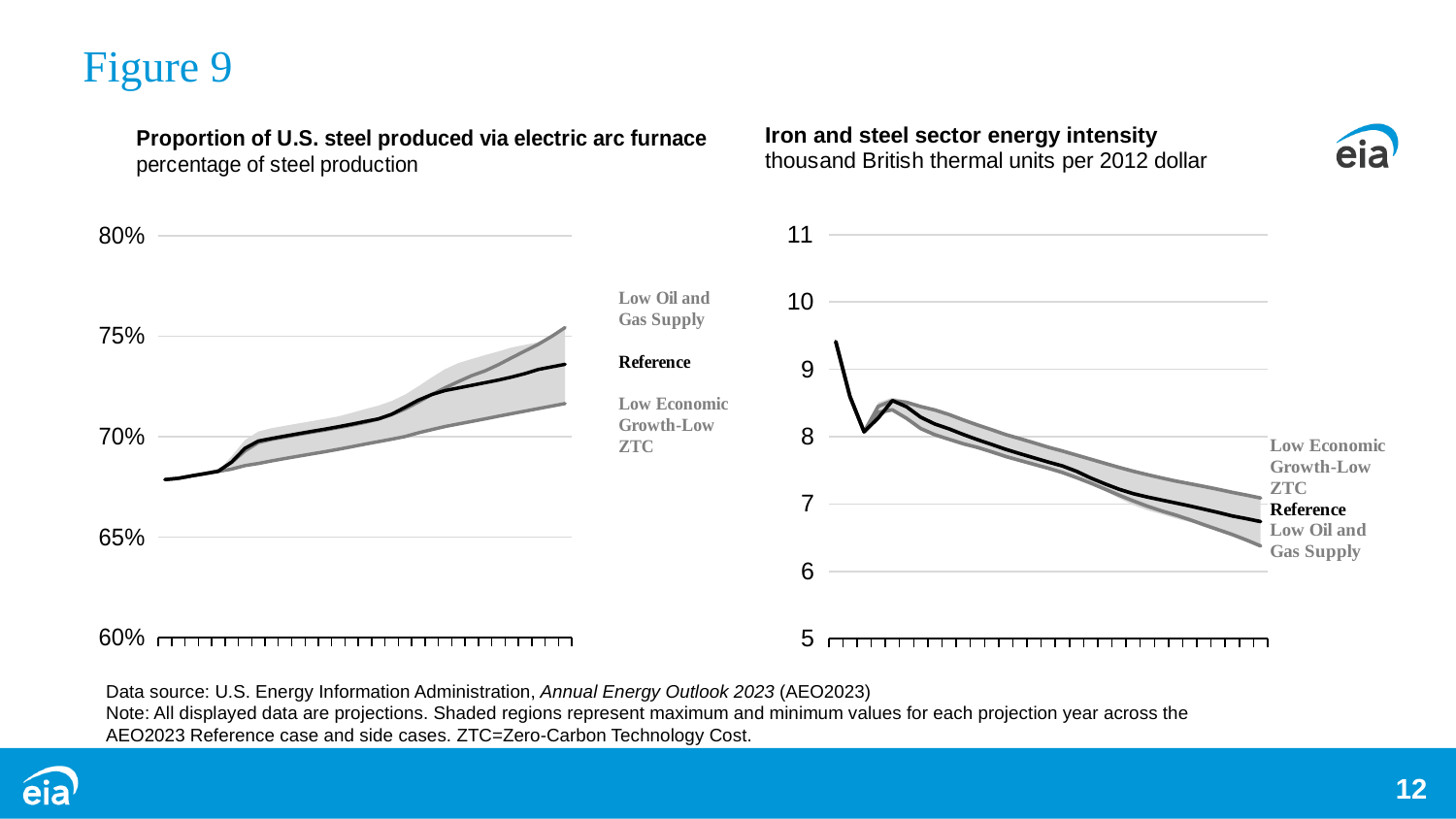
In the left chart, 'Proportion of U.S. steel produced via electric arc furnace', is the final value of the Low Economic Growth-Low ZTC line greater or less than 70%? greater What unit is given in the subtitle of the right chart, 'Iron and steel sector energy intensity'? thousand British thermal units per 2012 dollar In the right chart, 'Iron and steel sector energy intensity', is the starting value of the line greater or less than 9? greater What type of chart is the left chart, 'Proportion of U.S. steel produced via electric arc furnace'? line chart In the left chart, 'Proportion of U.S. steel produced via electric arc furnace', is the starting value of the lines greater or less than 70%? less In the right chart, 'Iron and steel sector energy intensity', do the values generally rise or fall along the x axis after the early peak? fall In the left chart, 'Proportion of U.S. steel produced via electric arc furnace', do the values generally rise or fall along the x axis? rise In the left chart, 'Proportion of U.S. steel produced via electric arc furnace', how many series are labeled? 3 In the right chart, 'Iron and steel sector energy intensity', how many series are labeled? 3 What type of chart is the right chart, 'Iron and steel sector energy intensity'? line chart